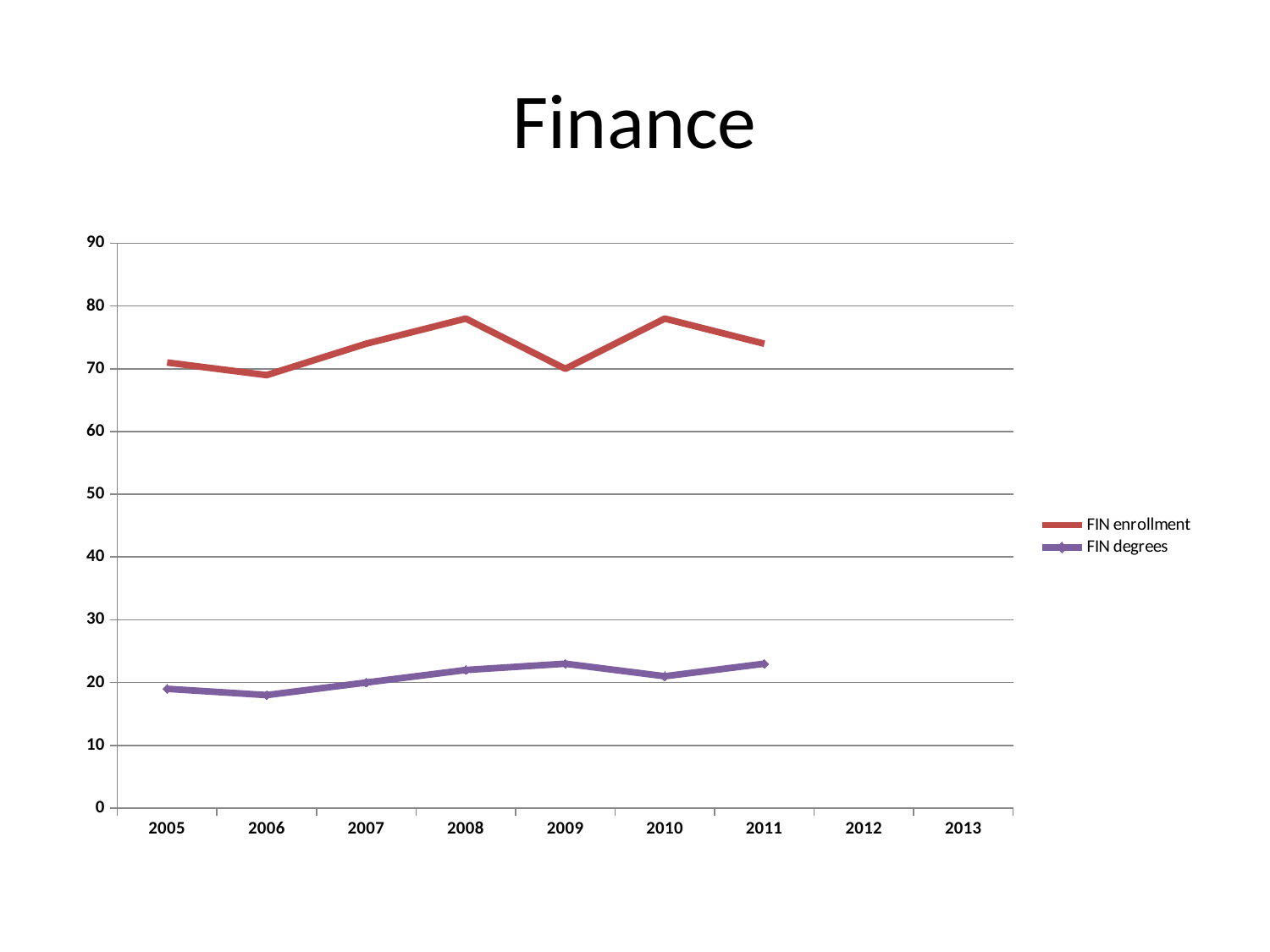
Which is larger, FIN enrollment in 2008 or FIN enrollment in 2009? 2008 How many year labels are shown on the x axis? 9 How many series does the legend list? 2 Is the value for FIN enrollment in 2009 greater or less than 80? less How many years have data points plotted for FIN enrollment? 7 Is the value for FIN enrollment in 2008 greater or less than 70? greater Is the value for FIN degrees in 2006 greater or less than 20? less What is the title of the slide? Finance What kind of chart is shown on the slide? line chart Which series is drawn in red? FIN enrollment Does FIN enrollment rise or fall from 2008 to 2009? fall Which is larger, FIN degrees in 2008 or FIN degrees in 2006? 2008